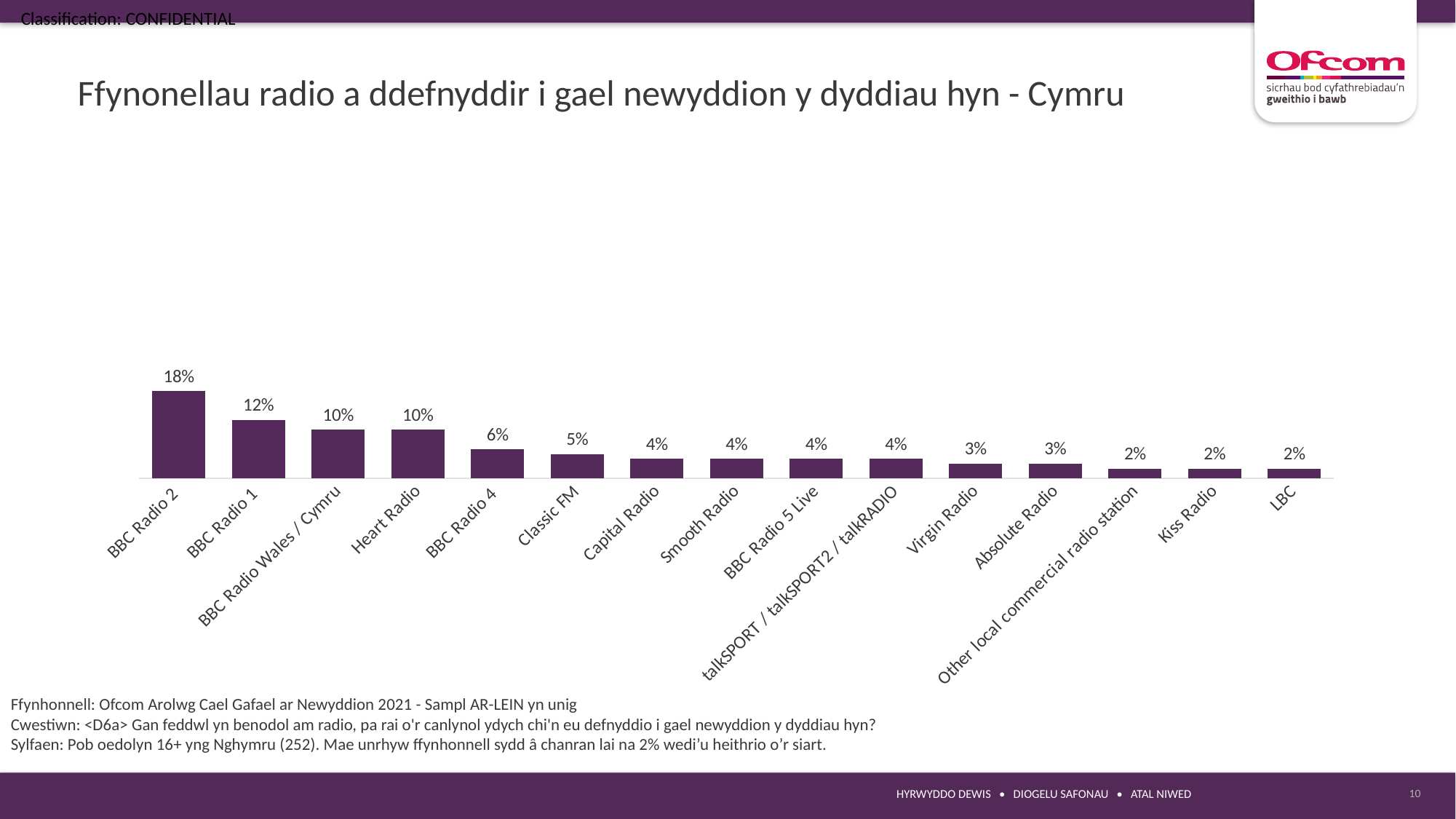
Do the values rise or fall from left to right across the chart? Fall What is the value for BBC Radio 2? 18% What kind of chart is shown on the slide? Bar chart What is the value for LBC? 2% Which is larger, Virgin Radio or Capital Radio? Capital Radio Which radio source has the highest value? BBC Radio 2 What is the value for Classic FM? 5% Which is larger, BBC Radio 1 or Heart Radio? BBC Radio 1 What is the value for BBC Radio Wales / Cymru? 10% What is the difference between BBC Radio 2 and BBC Radio 1? 6% What is the difference between Heart Radio and BBC Radio 4? 4% How many radio sources are shown in the chart? 15